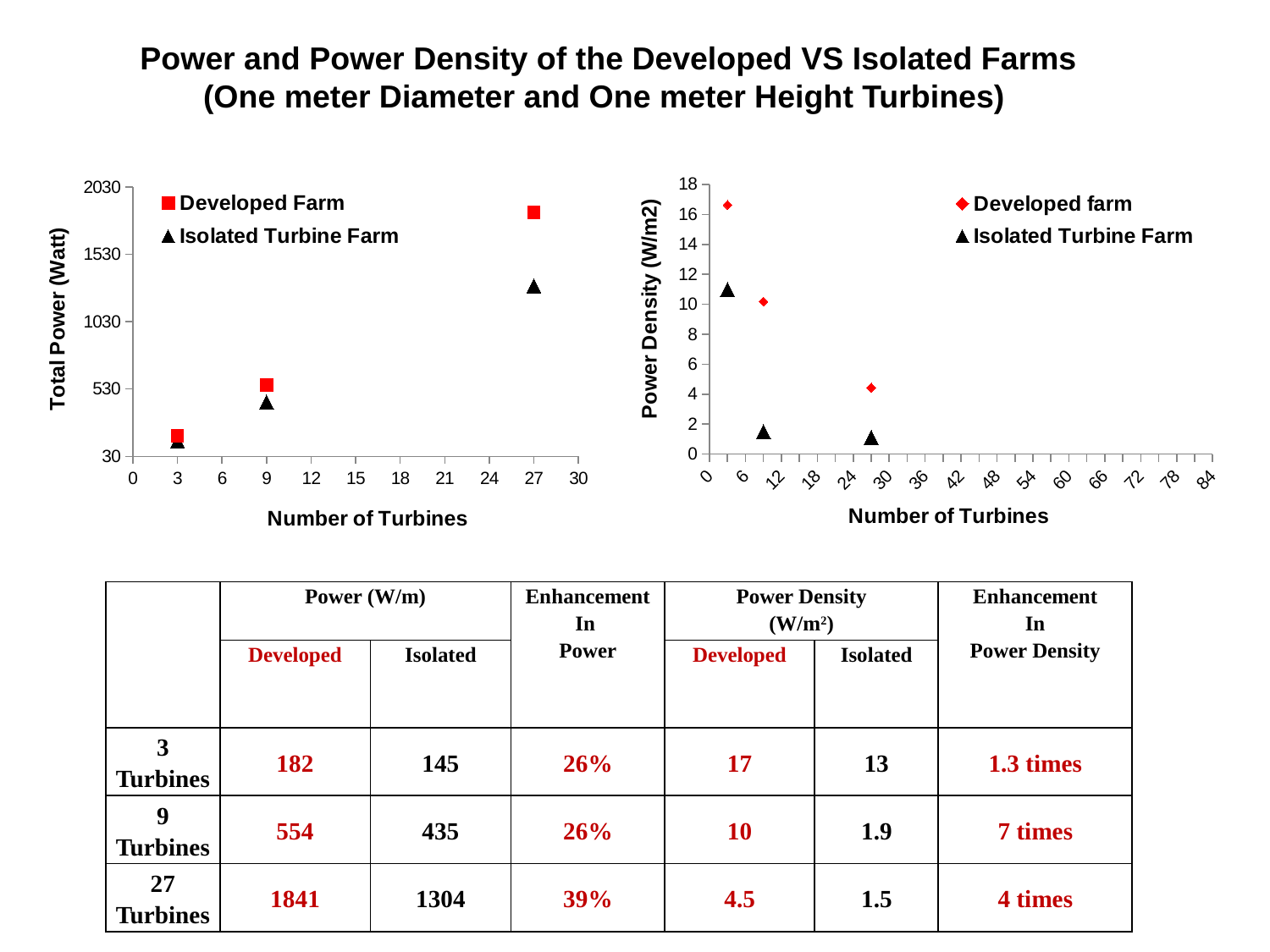
In the right chart (Power Density), which series has the highest plotted power density? Developed farm What is the y-axis title of the left chart? Total Power (Watt) In the left chart (Total Power), does the Developed Farm total power rise or fall as the number of turbines increases? rises In the left chart (Total Power), how many data points are plotted for the Developed Farm series? 3 In the left chart (Total Power), is the Isolated Turbine Farm value at 27 turbines greater or less than 1530? less How many series does the legend of the left chart (Total Power) list? 2 What kind of chart is the left chart, Total Power vs Number of Turbines? scatter chart In the left chart (Total Power), is the Developed Farm value at 27 turbines greater or less than 1530? greater In the right chart (Power Density), is the Isolated Turbine Farm value at 27 turbines greater or less than 2? less In the left chart (Total Power), at 27 turbines, which series has the higher total power? Developed Farm In the right chart (Power Density), does the Developed farm power density rise or fall as the number of turbines increases? falls